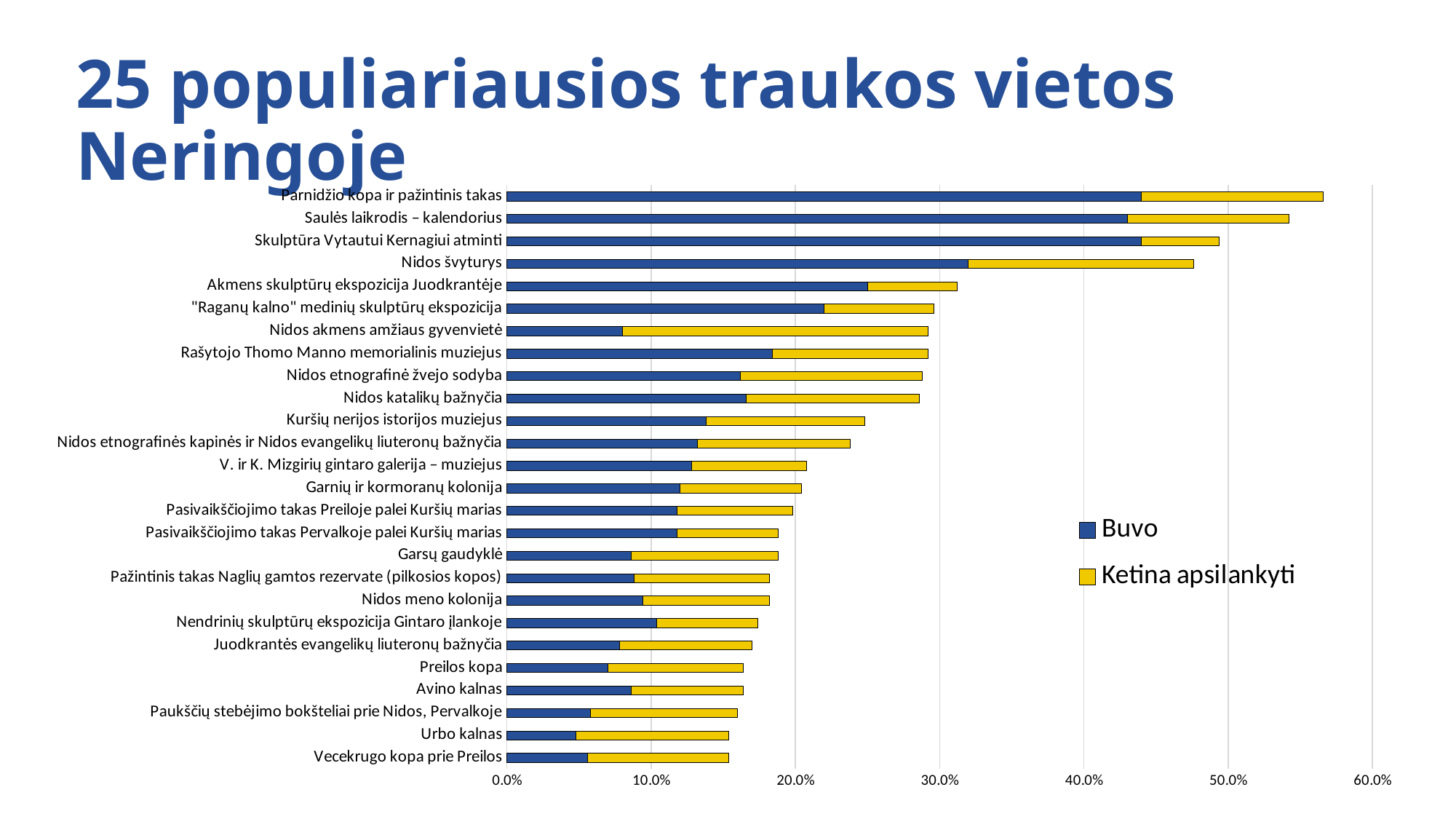
Which attraction has the longest total bar? Parnidžio kopa ir pažintinis takas Do the total bar lengths increase or decrease going from the top category to the bottom category? decrease How many attractions (categories) are plotted on the chart? 26 Is the total bar for Urbo kalnas greater or less than 20.0%? less Is the Buvo value for Nidos švyturys greater or less than 30.0%? greater Is the Buvo value for Saulės laikrodis – kalendorius greater or less than 40.0%? greater Which has the larger Buvo value: Nidos švyturys or Akmens skulptūrų ekspozicija Juodkrantėje? Nidos švyturys What kind of chart is shown on the slide? Stacked bar chart What are the two series named in the legend? Buvo and Ketina apsilankyti How many series does the legend list? 2